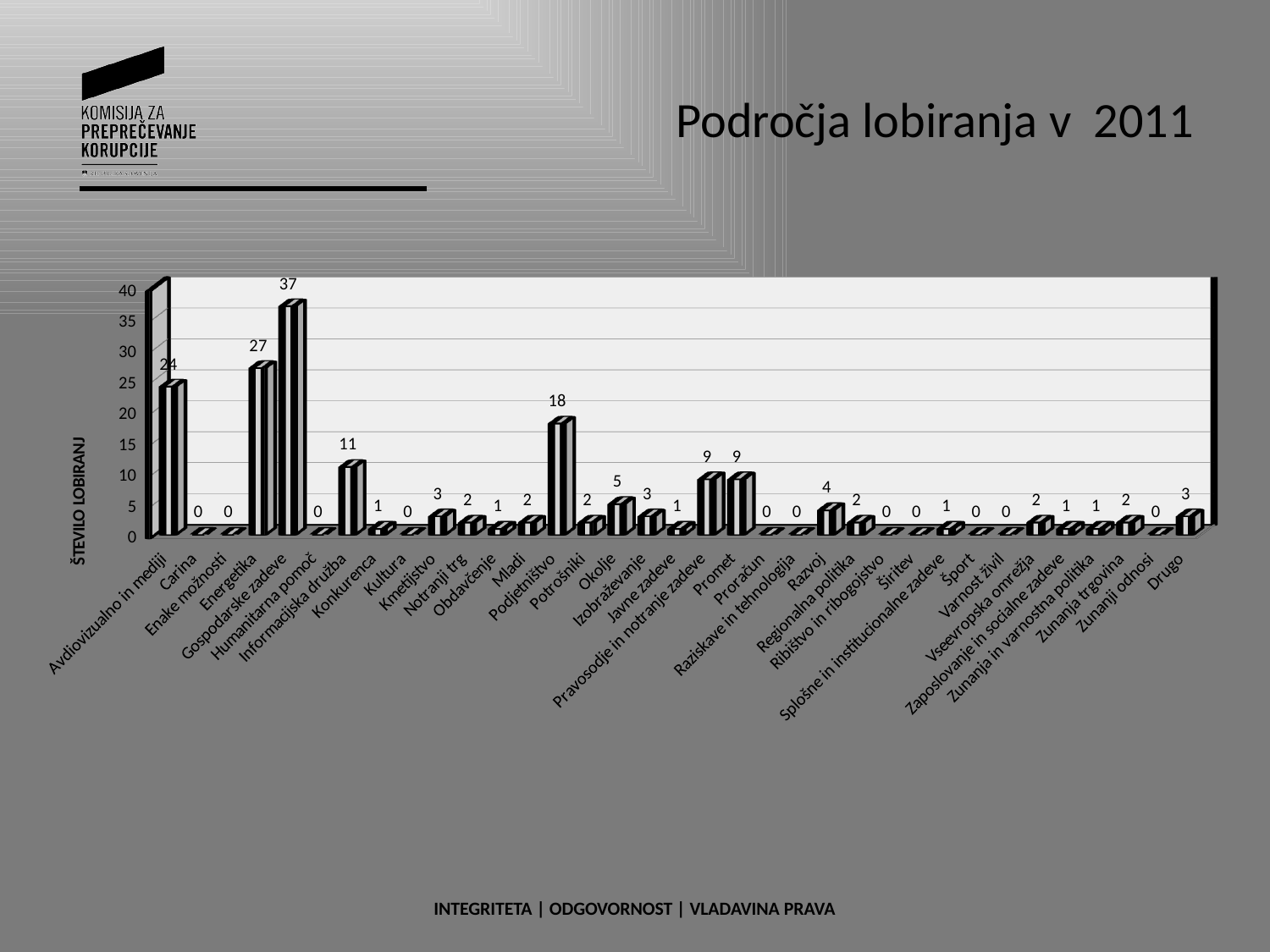
What kind of chart is shown on the slide? Bar chart What is the difference between the values for Avdiovizualno in mediji and Podjetništvo? 6 Which is larger, the value for Razvoj or the value for Okolje? Okolje Which is larger, the value for Energetika or the value for Avdiovizualno in mediji? Energetika What is the difference between the values for Gospodarske zadeve and Energetika? 10 What is the value for Gospodarske zadeve? 37 What is the value for Avdiovizualno in mediji? 24 What is the value for Podjetništvo? 18 What is the title of the chart on the slide? Področja lobiranja v 2011 Which category has the highest value? Gospodarske zadeve What is the value for Informacijska družba? 11 What is the value for Okolje? 5